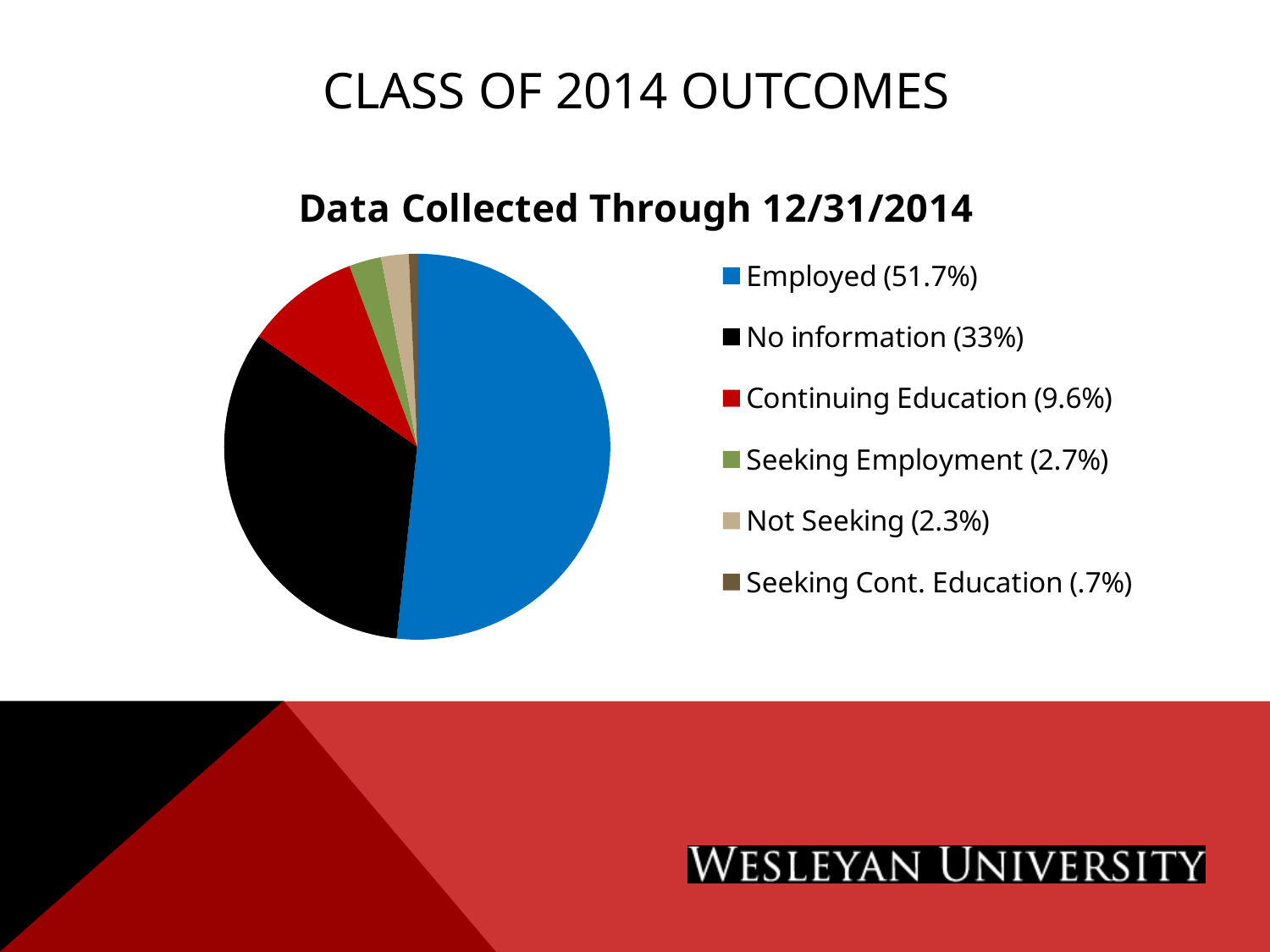
Which category has the largest share of the pie? Employed What kind of chart is shown on the slide? pie chart What percentage of the Class of 2014 is Employed? 51.7% What is the chart's title? Data Collected Through 12/31/2014 What colour represents the Employed slice? blue Which is larger, Seeking Employment or Not Seeking? Seeking Employment What is the difference in percentage points between Employed and No information? 18.7 What percentage is listed for Seeking Cont. Education? .7% What percentage is listed for No information? 33% How many categories does the legend list? 6 What percentage is listed for Continuing Education? 9.6% Which category has the smallest share of the pie? Seeking Cont. Education